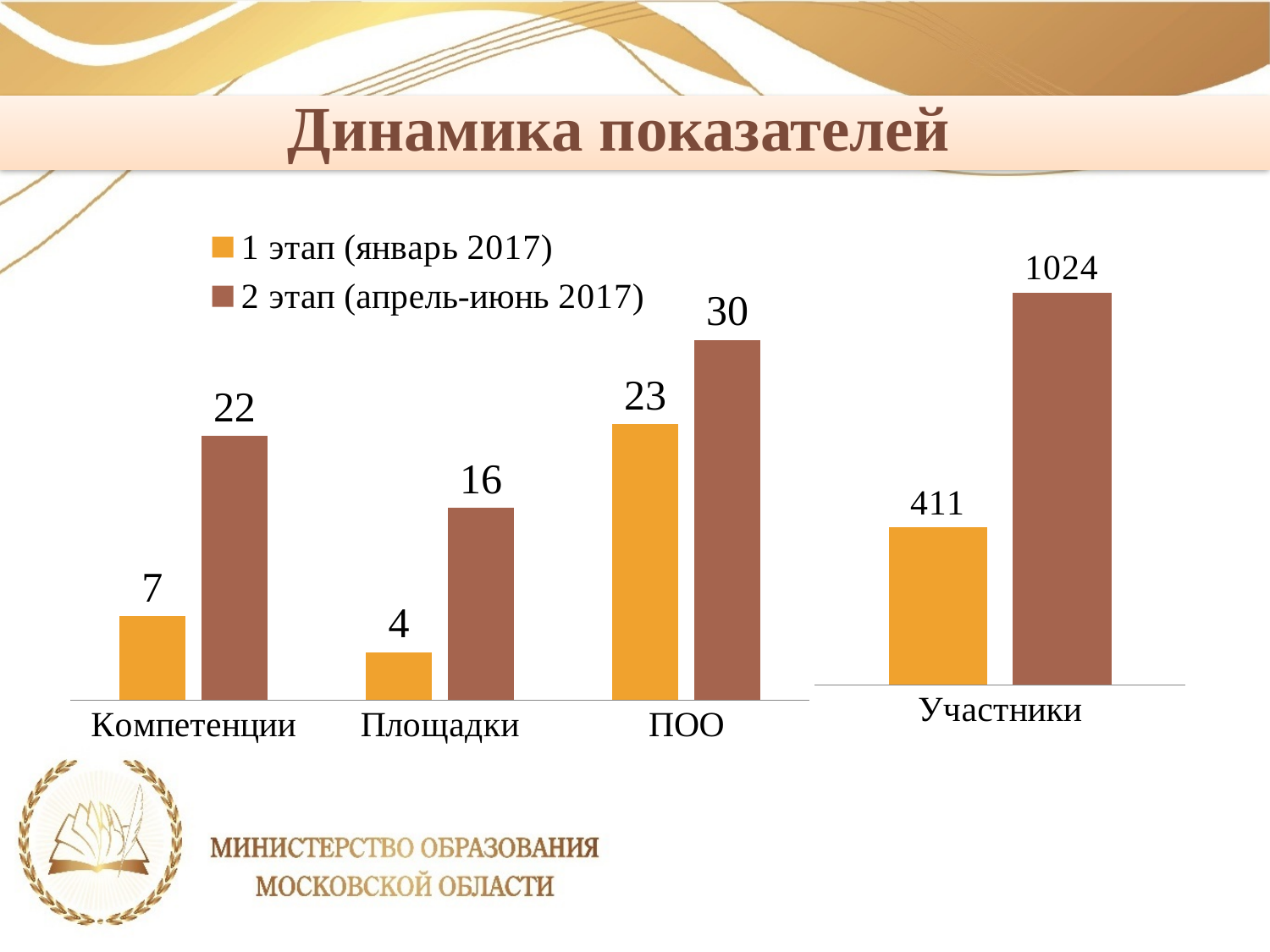
In the left chart, what is the value for Компетенции in 1 этап (январь 2017)? 7 In the right chart, what is the value for Участники in 2 этап (апрель-июнь 2017)? 1024 In the right chart, what is the difference between the 2 этап and 1 этап values for Участники? 613 How many series does the legend list? 2 What type of chart is shown on the slide? Bar chart In the right chart, what is the value for Участники in 1 этап (январь 2017)? 411 In the left chart, what is the difference between the 2 этап and 1 этап values for Компетенции? 15 In the left chart, which category has the lowest value in 2 этап (апрель-июнь 2017)? Площадки In the left chart, which category has the highest value in 1 этап (январь 2017)? ПОО In the left chart, which is larger for Площадки: the 1 этап value or the 2 этап value? 2 этап (апрель-июнь 2017) In the left chart, what is the value for Площадки in 2 этап (апрель-июнь 2017)? 16 In the left chart, what is the value for ПОО in 2 этап (апрель-июнь 2017)? 30